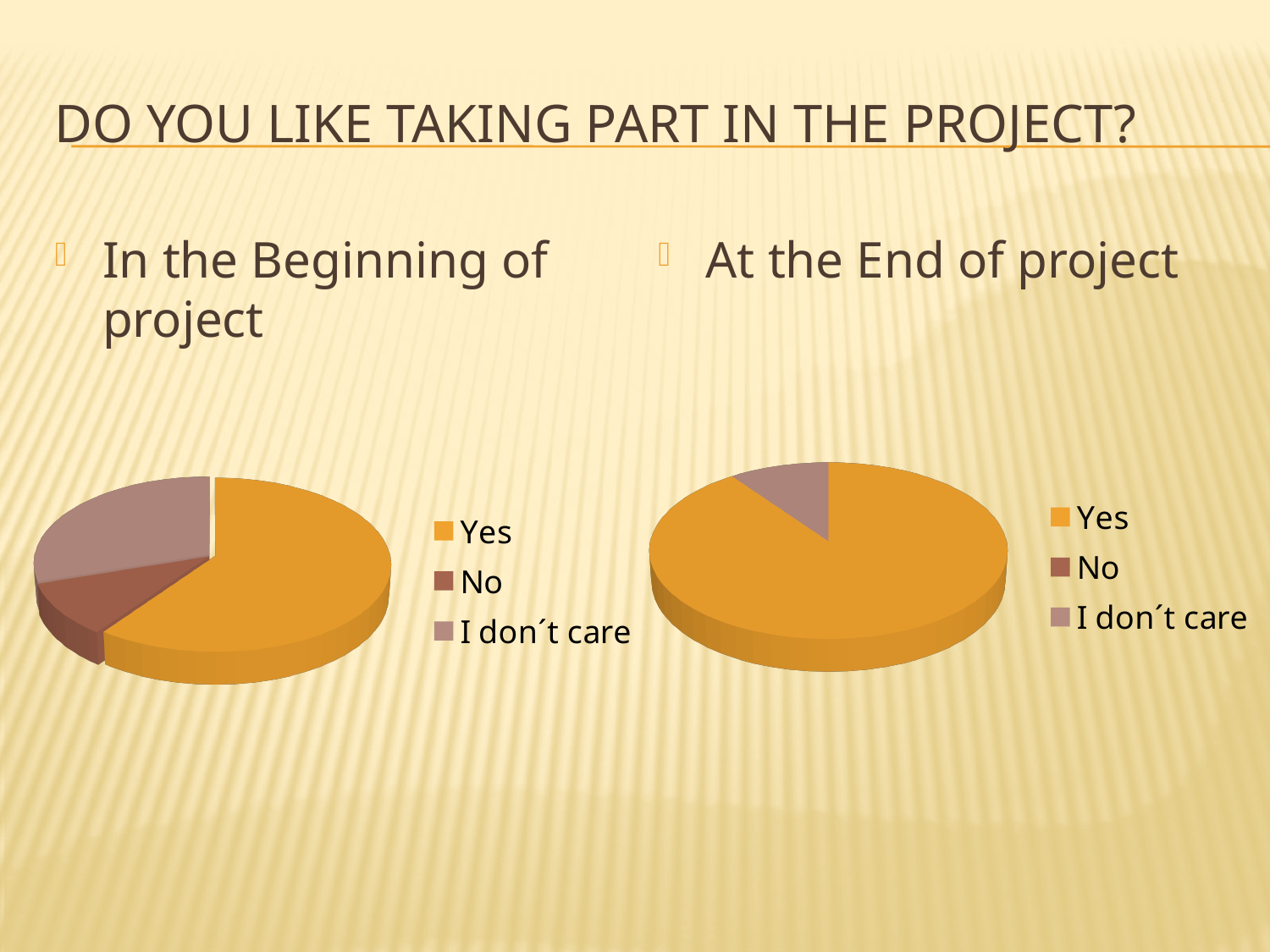
In the 'In the Beginning of project' chart, which category has the largest slice? Yes What is the title of the slide containing the two pie charts? DO YOU LIKE TAKING PART IN THE PROJECT? In the 'In the Beginning of project' chart, which category has the smallest slice? No What kind of chart is the 'In the Beginning of project' chart? pie chart In the 'In the Beginning of project' chart, how many categories does the legend list? 3 In the 'At the End of project' chart, which category has the largest slice? Yes In the 'At the End of project' chart, which slice is larger, 'Yes' or 'I don´t care'? Yes In the 'In the Beginning of project' chart, which slice is larger, 'No' or 'I don´t care'? I don´t care In the 'At the End of project' chart, what colour is the 'Yes' slice? orange What kind of chart is the 'At the End of project' chart? pie chart In the 'At the End of project' chart, how many categories does the legend list? 3 Which chart has the larger 'Yes' slice, 'In the Beginning of project' or 'At the End of project'? At the End of project